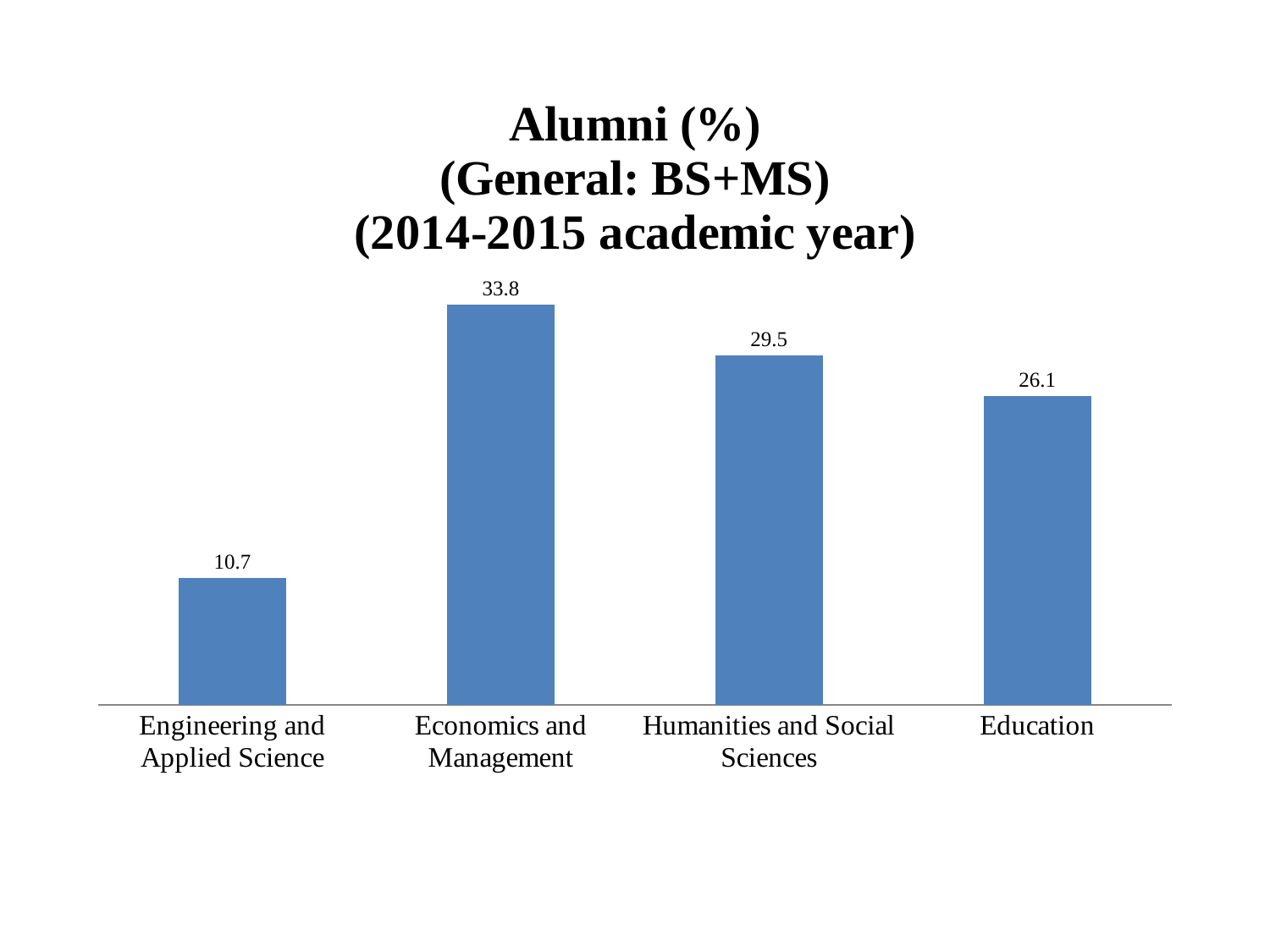
What is the difference between the values for Economics and Management and Education? 7.7 What is the value for Humanities and Social Sciences? 29.5 Which is larger, the value for Humanities and Social Sciences or the value for Education? Humanities and Social Sciences What is the difference between the values for Humanities and Social Sciences and Engineering and Applied Science? 18.8 What is the value for Economics and Management? 33.8 Which category has the highest value? Economics and Management How many categories are shown in the chart? 4 Which academic year does the chart title refer to? 2014-2015 academic year Which category has the lowest value? Engineering and Applied Science What is the value for Education? 26.1 What kind of chart is shown on the slide? Bar chart What is the value for Engineering and Applied Science? 10.7